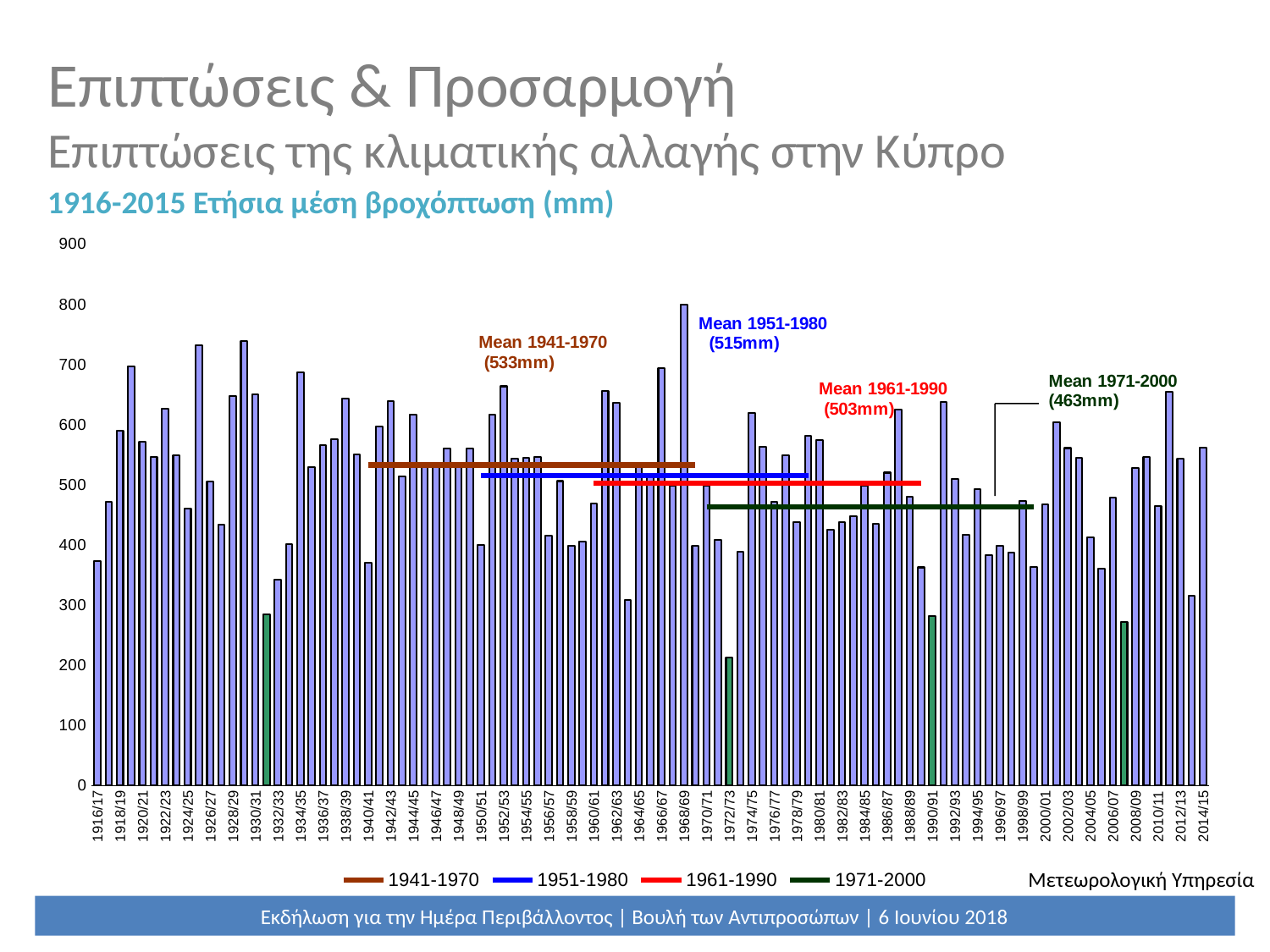
How many series does the legend list? 4 What is the mean annual rainfall shown for the period 1971-2000? 463mm Is the rainfall value for 1972/73 greater or less than 300? less Is the rainfall value for 1968/69 greater or less than 700? greater Which of the four labelled periods has the lowest mean rainfall? 1971-2000 Which of the four labelled periods has the highest mean rainfall? 1941-1970 Which period has the higher mean rainfall, 1951-1980 or 1961-1990? 1951-1980 What is the mean annual rainfall shown for the period 1941-1970? 533mm What is the mean annual rainfall shown for the period 1961-1990? 503mm What kind of chart is used to show the annual rainfall values? bar chart What is the difference between the mean for 1941-1970 and the mean for 1971-2000? 70mm Do the period means rise or fall from 1941-1970 through to 1971-2000? fall